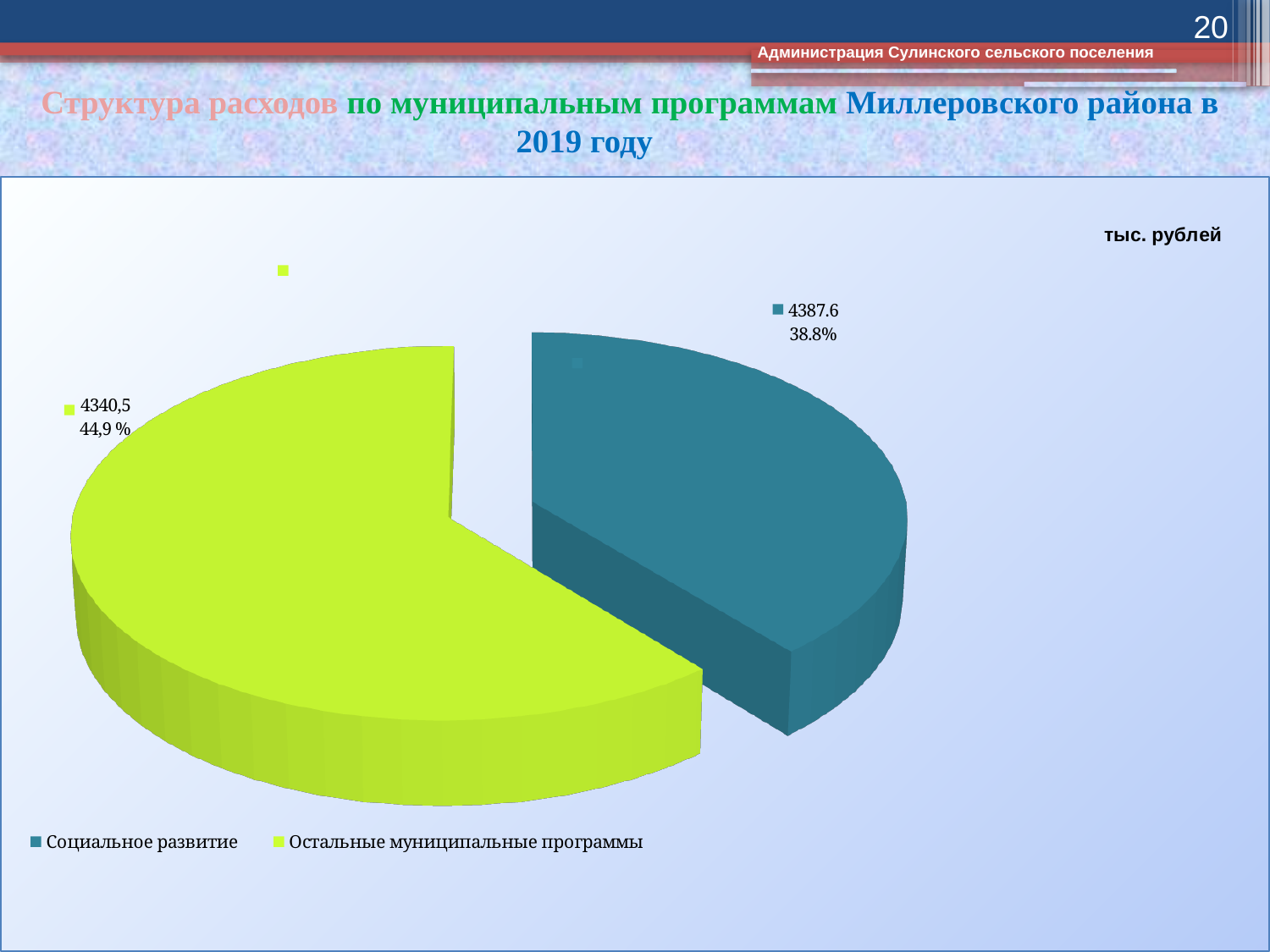
What percentage is printed for the "Социальное развитие" slice? 38.8% What value is printed for the "Остальные муниципальные программы" slice? 4340,5 What value is printed for the "Социальное развитие" slice? 4387.6 Which legend entry is shown in green? Остальные муниципальные программы How many slices does the pie chart have? 2 How many entries does the legend list? 2 What unit is indicated for the values in the chart? тыс. рублей What kind of chart is shown on the slide? pie chart What percentage is printed for the "Остальные муниципальные программы" slice? 44,9 %